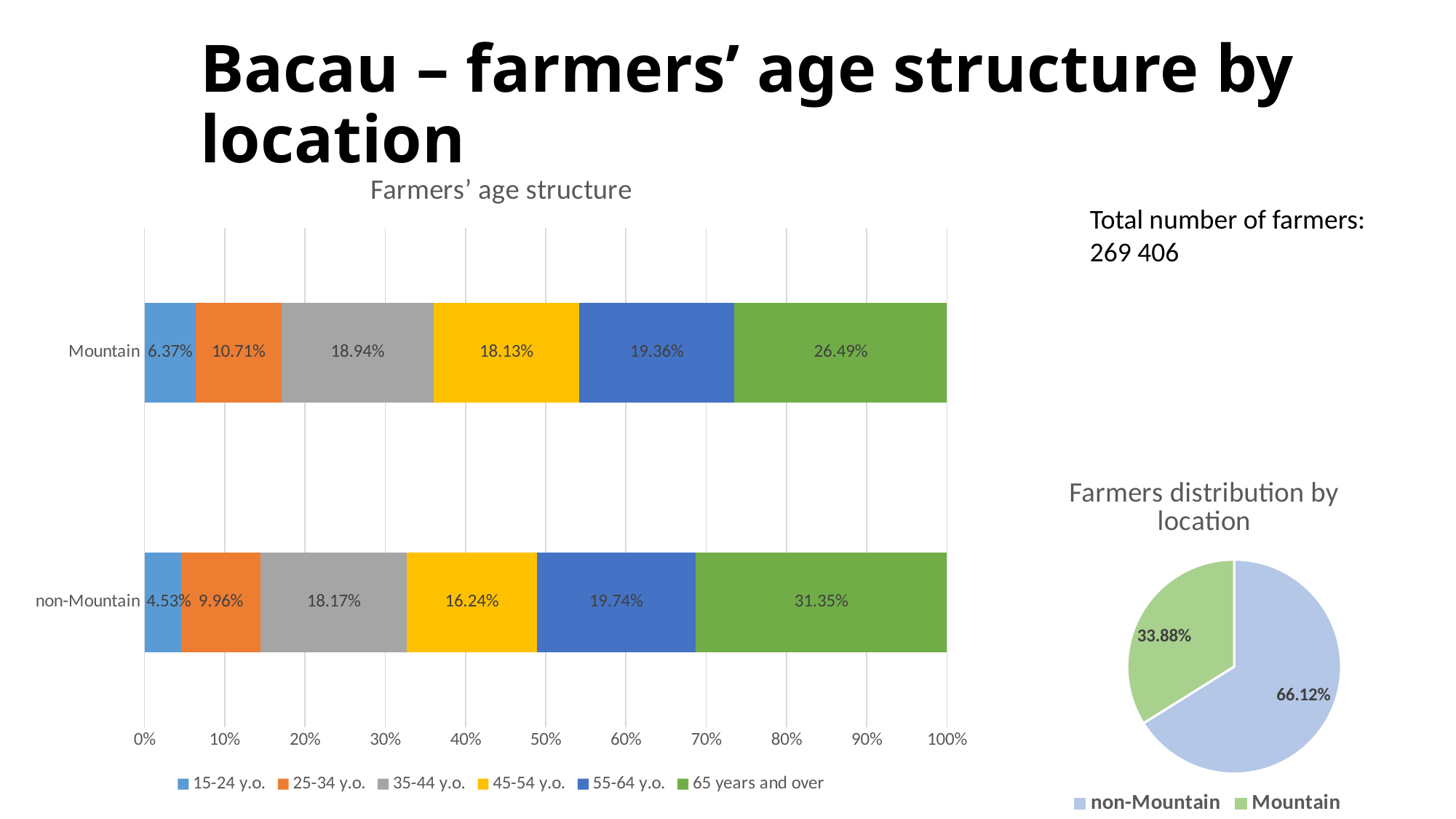
In the 'Farmers distribution by location' pie chart, what share is Mountain? 33.88% In the 'Farmers' age structure' chart, which age group has the smallest share in the non-Mountain bar? 15-24 y.o. In the 'Farmers distribution by location' pie chart, which slice is larger, non-Mountain or Mountain? non-Mountain How many series does the legend of the 'Farmers' age structure' chart list? 6 In the 'Farmers' age structure' chart, what is the difference between the 65 years and over shares for non-Mountain and Mountain? 4.86% In the 'Farmers' age structure' chart, what is the value for 15-24 y.o. in the Mountain bar? 6.37% In the 'Farmers' age structure' chart, what is the value for 45-54 y.o. in the non-Mountain bar? 16.24% In the 'Farmers' age structure' chart, is the 35-44 y.o. share larger for Mountain or non-Mountain? Mountain How many categories (bars) are shown in the 'Farmers' age structure' chart? 2 In the 'Farmers' age structure' chart, which age group has the largest share in the Mountain bar? 65 years and over In the 'Farmers' age structure' chart, what is the value for 65 years and over in the non-Mountain bar? 31.35% What kind of chart is 'Farmers distribution by location'? Pie chart